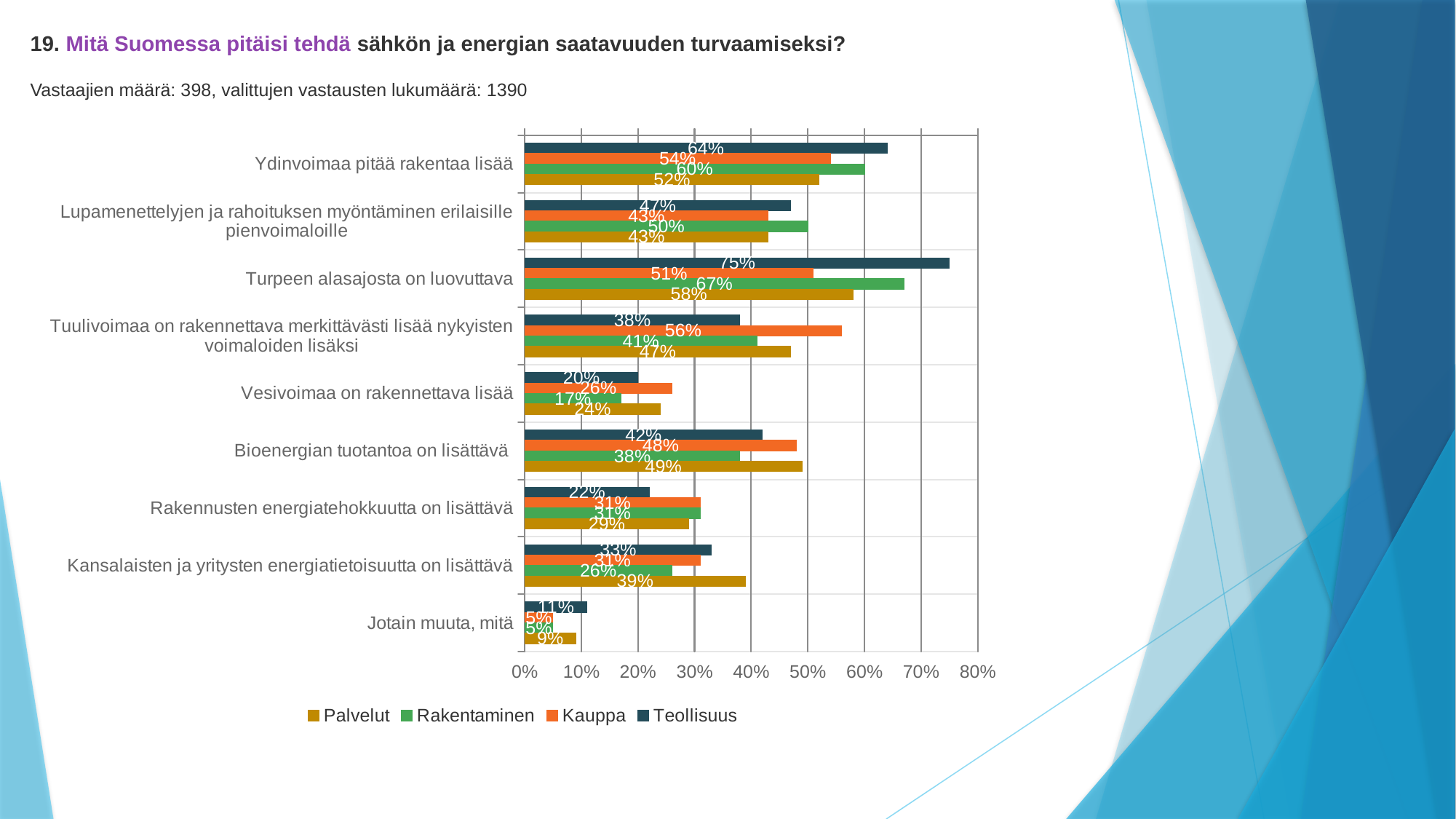
What is the Palvelut value for "Ydinvoimaa pitää rakentaa lisää"? 52% What is the difference between the Teollisuus and Palvelut values for "Ydinvoimaa pitää rakentaa lisää"? 12% What is the Kauppa value for "Tuulivoimaa on rakennettava merkittävästi lisää nykyisten voimaloiden lisäksi"? 56% Which category has the highest Teollisuus value? Turpeen alasajosta on luovuttava Is the Rakentaminen value for "Vesivoimaa on rakennettava lisää" greater or less than 20%? less Which series is shown in orange in the legend? Kauppa How many series does the legend list? 4 What is the Teollisuus value for "Turpeen alasajosta on luovuttava"? 75% How many categories are shown on the chart? 9 What kind of chart is shown on the slide? bar chart Which category has the lowest Palvelut value? Jotain muuta, mitä For "Bioenergian tuotantoa on lisättävä", which is larger: the Kauppa value or the Rakentaminen value? Kauppa